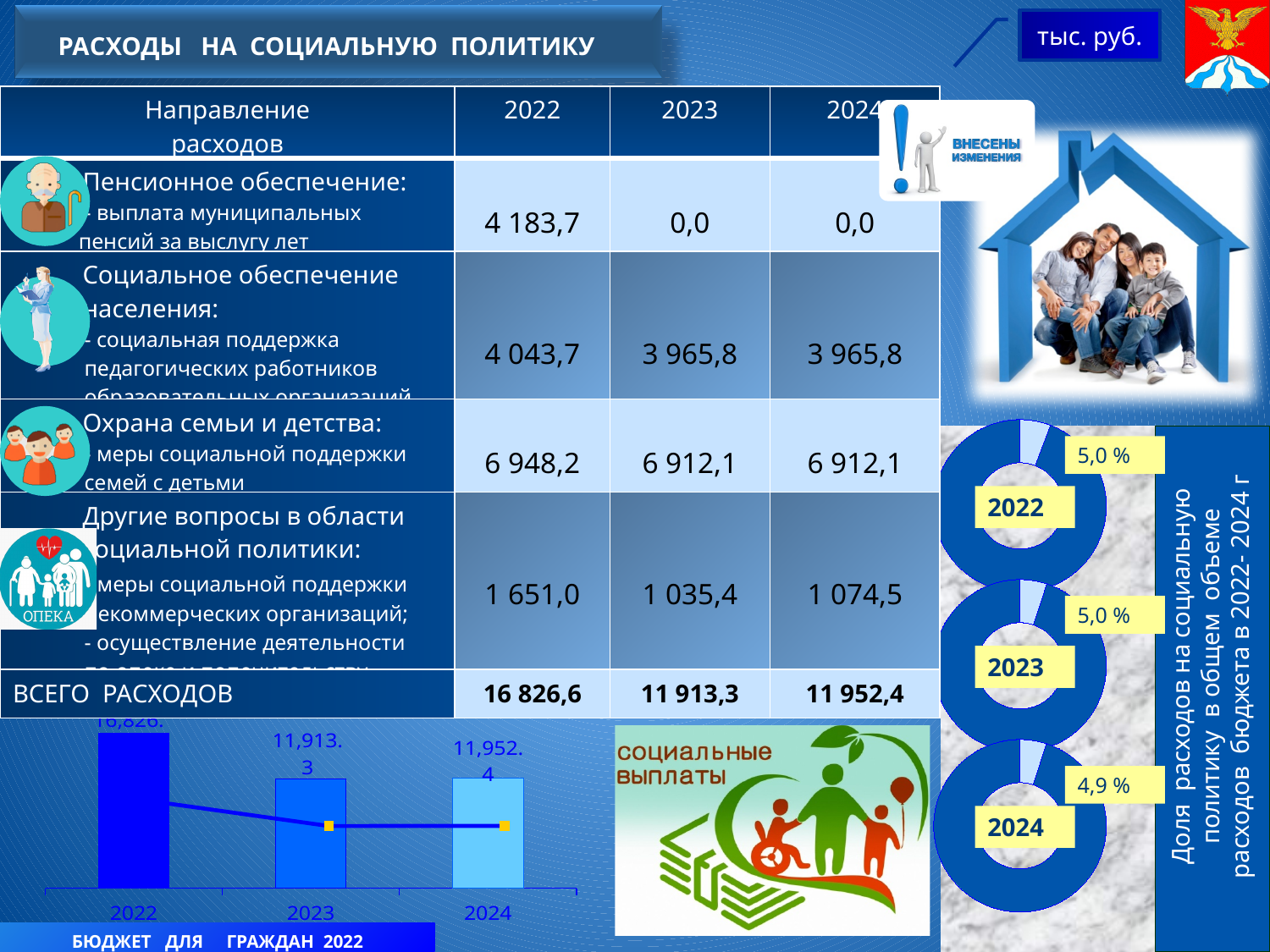
In the bar chart at the bottom left, which year has the highest bar? 2022 In the bar chart at the bottom left, which year has the lowest bar? 2023 In the bar chart at the bottom left, does the value rise or fall from 2022 to 2023? fall In the bar chart at the bottom left, what is the value shown for 2023? 11,913.3 In the bar chart at the bottom left, which is larger, the value for 2023 or the value for 2024? 2024 What kind of chart is shown at the bottom left of the slide? bar chart In the bar chart at the bottom left, what is the difference between the 2024 value and the 2023 value? 39.1 In the bar chart at the bottom left, what is the value shown for 2024? 11,952.4 In the donut charts on the right, what share is shown for 2022? 5,0 % In the donut charts on the right, which year has the lowest share? 2024 In the bar chart at the bottom left, how many years are plotted? 3 In the donut charts on the right, what share is shown for 2024? 4,9 %